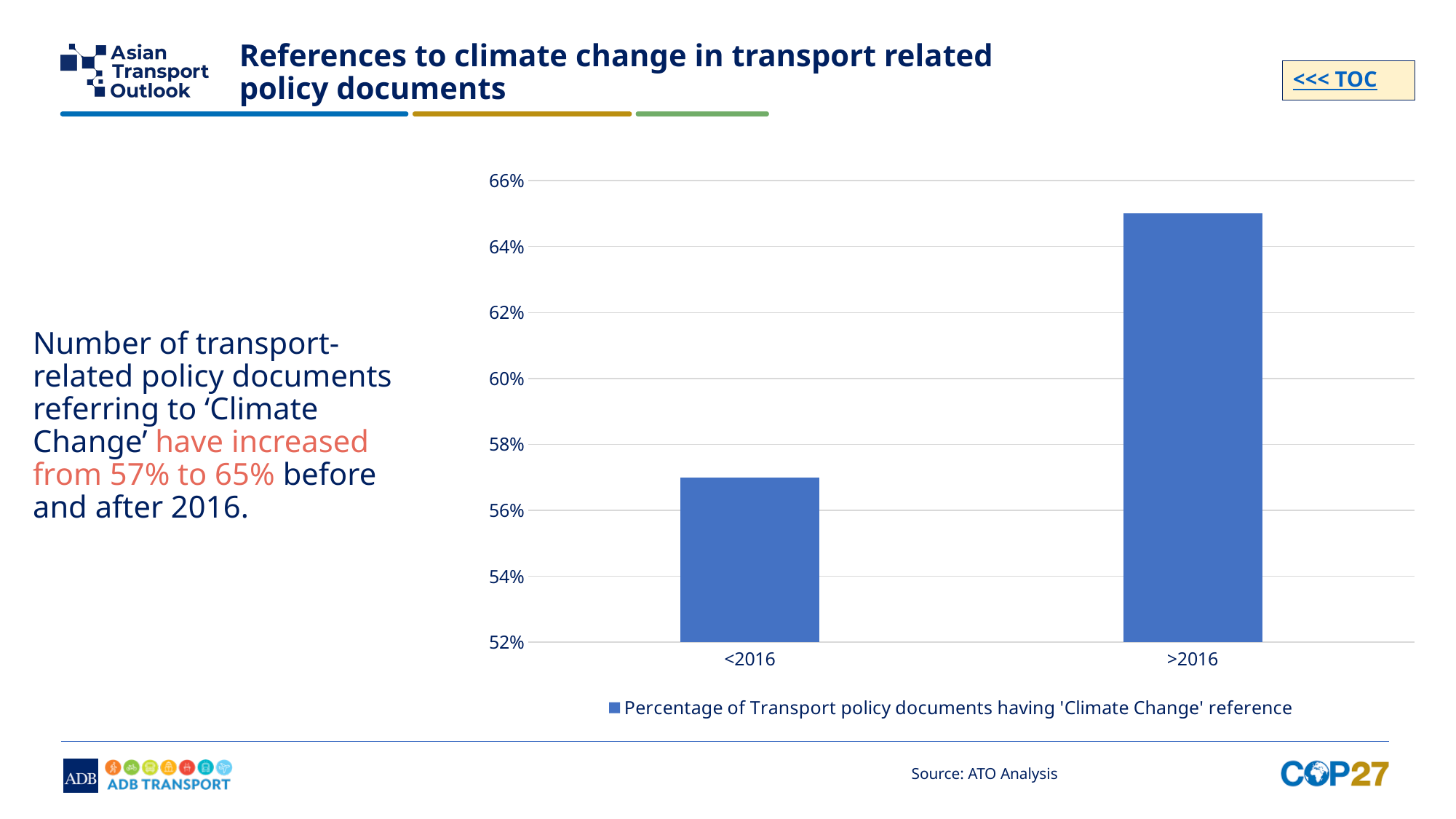
How many series does the chart legend list? 1 What type of chart is shown on the slide? bar chart How many categories are shown on the x axis of the chart? 2 Which category has the highest value in the chart? >2016 Is the value for <2016 greater or less than 56%? greater Is the value for >2016 greater or less than 64%? greater What is the title of the chart slide? References to climate change in transport related policy documents What is the legend entry for the series in the chart? Percentage of Transport policy documents having 'Climate Change' reference Which category has the lowest value in the chart? <2016 Is the value for <2016 greater or less than 58%? less Do the values rise or fall from <2016 to >2016? rise Which category has the higher value, <2016 or >2016? >2016